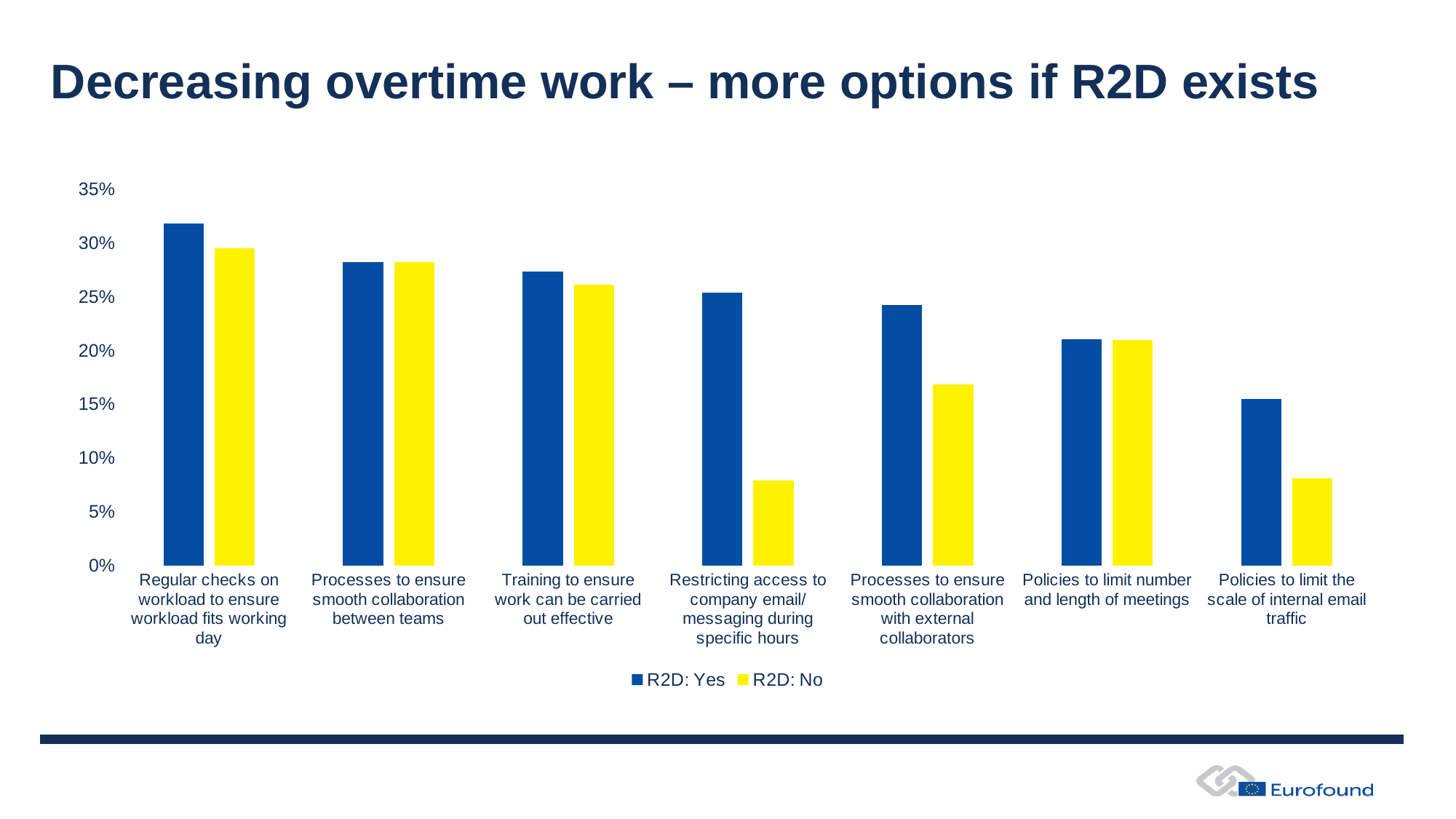
Is the R2D: Yes value for 'Training to ensure work can be carried out effective' greater or less than 25%? greater Is the R2D: Yes value for 'Regular checks on workload to ensure workload fits working day' greater or less than 30%? greater Is the R2D: No value for 'Restricting access to company email/messaging during specific hours' greater or less than 10%? less What colour are the R2D: No bars? yellow How many series does the legend list? 2 Which category has the highest value for R2D: Yes? Regular checks on workload to ensure workload fits working day Which category has the lowest value for R2D: Yes? Policies to limit the scale of internal email traffic How many categories are shown on the x axis? 7 Do the R2D: Yes values rise or fall from left to right across the categories? fall For 'Restricting access to company email/messaging during specific hours', which is larger: R2D: Yes or R2D: No? R2D: Yes What kind of chart is shown on the slide? bar chart